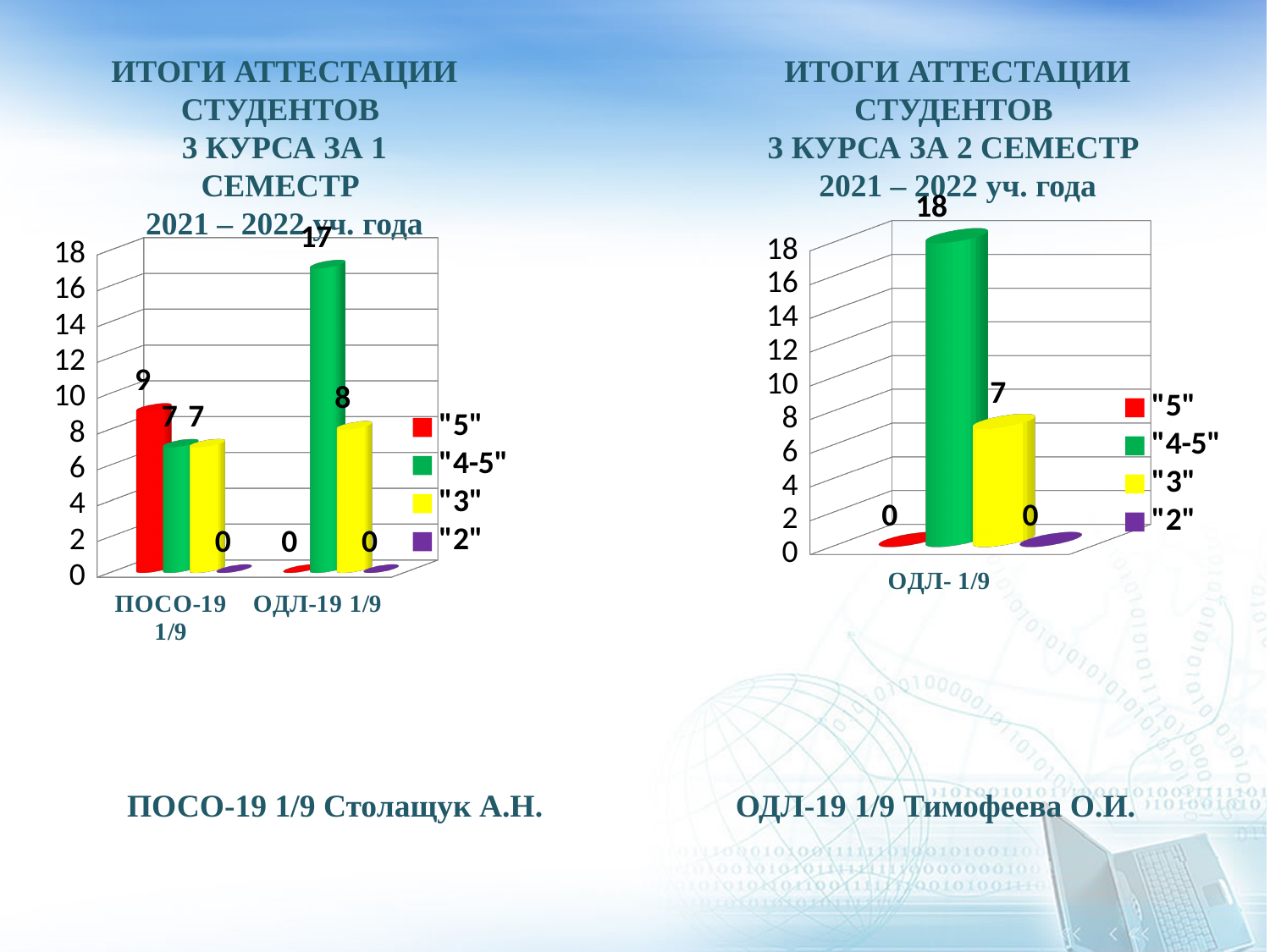
In the left chart (1 семестр), what is the value of "3" for ОДЛ-19 1/9? 8 In the right chart (2 семестр), what is the difference between the "4-5" and "3" values for ОДЛ- 1/9? 11 In the right chart (2 семестр), what is the value of "4-5" for ОДЛ- 1/9? 18 What type of chart is the right chart (2 семестр)? Bar chart How many categories are shown on the x axis of the left chart (1 семестр)? 2 How many series does the legend of the right chart (2 семестр) list? 4 In the left chart (1 семестр), which is larger for ПОСО-19 1/9: the "5" value or the "3" value? "5" In the left chart (1 семестр), which series has the highest value for ОДЛ-19 1/9? "4-5" In the left chart (1 семестр), what is the value of "4-5" for ОДЛ-19 1/9? 17 In the left chart (1 семестр), what is the difference between the "4-5" value for ОДЛ-19 1/9 and the "4-5" value for ПОСО-19 1/9? 10 In the left chart (1 семестр), what is the value of "5" for ПОСО-19 1/9? 9 In the right chart (2 семестр), what is the value of "3" for ОДЛ- 1/9? 7